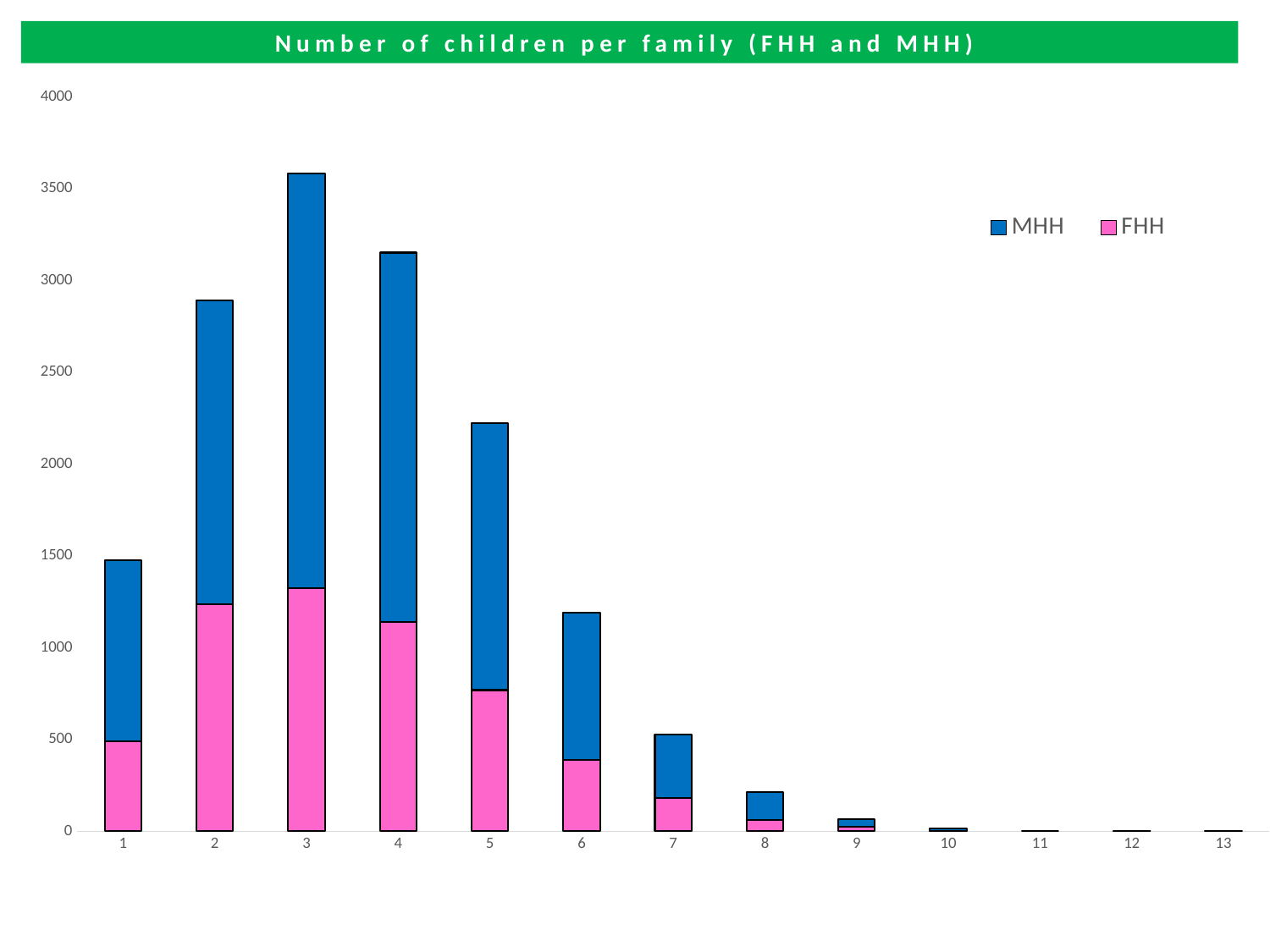
Is the total value for 2 children greater or less than 2500? greater Is the FHH value for 5 children greater or less than 500? greater Which has the larger FHH value, 3 children or 4 children? 3 children Which number of children has the tallest stacked bar? 3 Which has the larger total bar, 4 children or 2 children? 4 children How many series does the legend list? 2 Is the FHH value for 3 children greater or less than 1000? greater What is the title of the chart? Number of children per family (FHH and MHH) How many categories are shown on the x axis? 13 What kind of chart is shown on the slide? Stacked bar chart